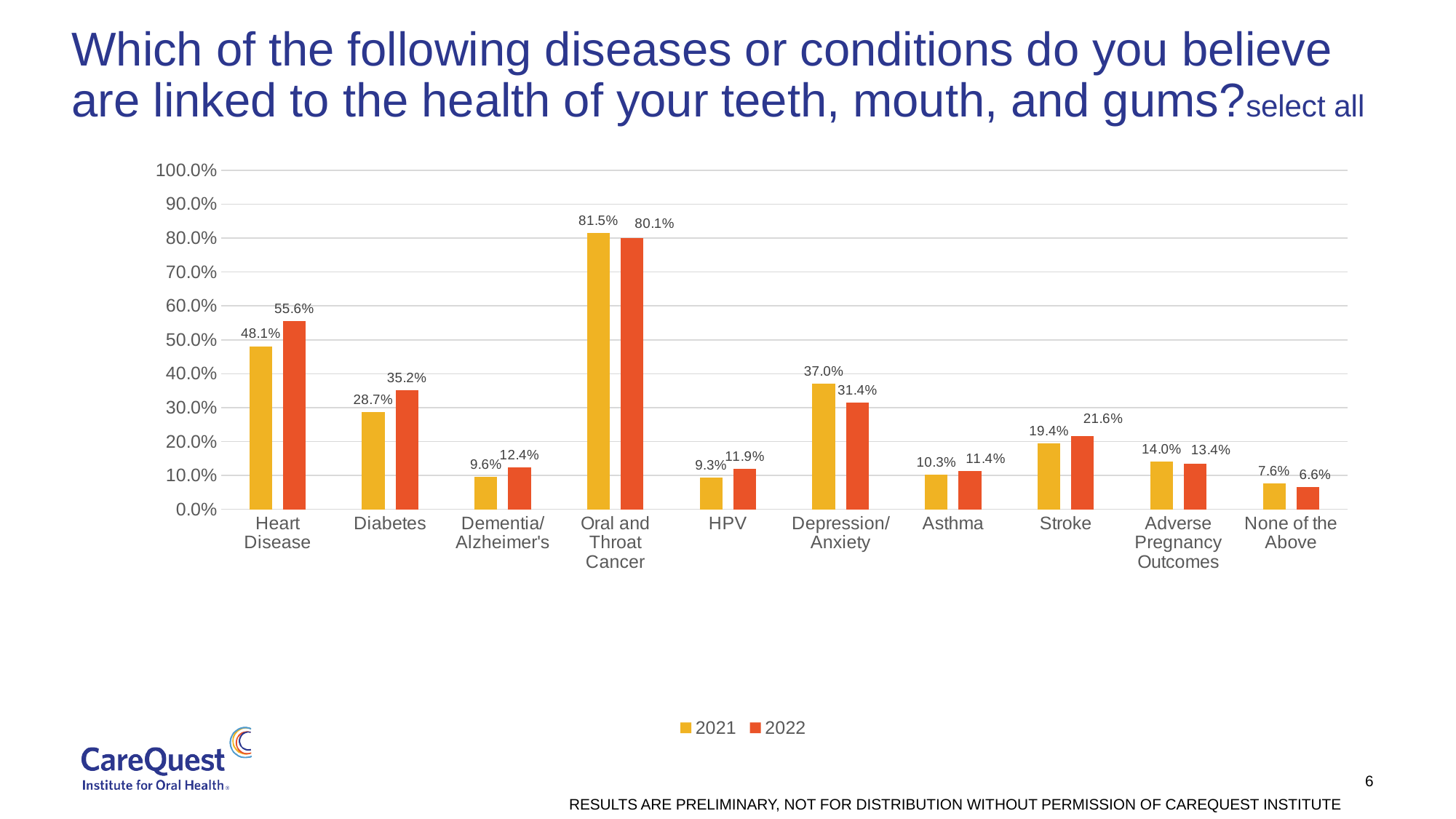
How many categories are shown on the x axis? 10 Which category has the lowest 2022 value? None of the Above What is the difference between the 2022 and 2021 values for Diabetes? 6.5% How many series does the legend list? 2 What is the 2022 value for Heart Disease? 55.6% What is the difference between the 2021 and 2022 values for Oral and Throat Cancer? 1.4% Is the 2021 value for Heart Disease greater or less than 50.0%? less Which is larger for Depression/Anxiety, the 2021 value or the 2022 value? 2021 Which category has the highest 2021 value? Oral and Throat Cancer What kind of chart is shown on the slide? bar chart What is the 2021 value for Depression/Anxiety? 37.0% What is the 2022 value for Stroke? 21.6%